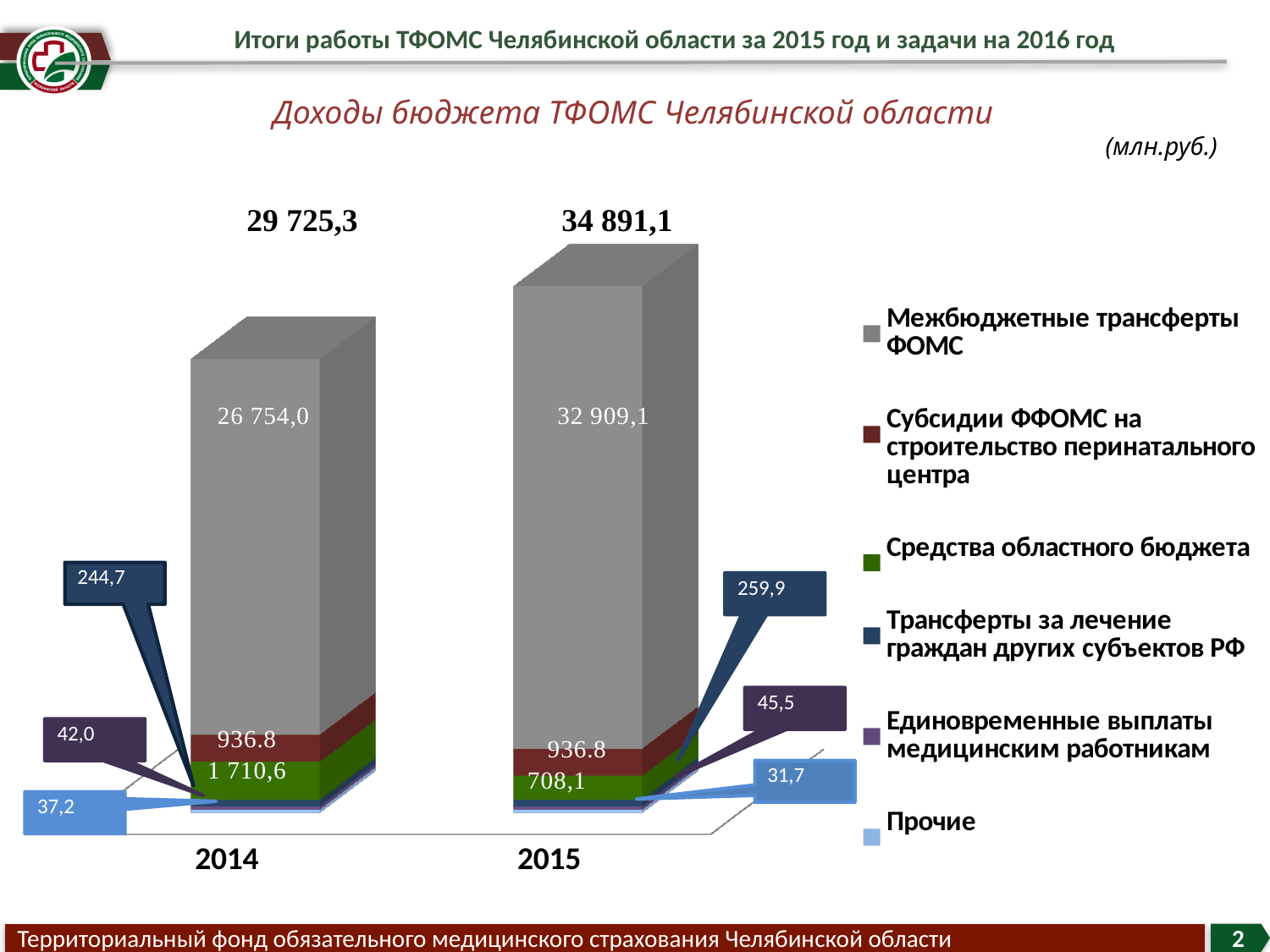
What is the value of Прочие for 2014? 37,2 What type of chart is shown on the slide? Stacked bar chart What is the difference between the total budget income in 2015 and in 2014? 5 165,8 Did the total budget income rise or fall from 2014 to 2015? Rise What is the value of Трансферты за лечение граждан других субъектов РФ for 2015? 259,9 How many series does the legend list? 6 What is the value of Средства областного бюджета for 2015? 708,1 Which year has the larger value for Средства областного бюджета, 2014 or 2015? 2014 By how much did Межбюджетные трансферты ФОМС increase from 2014 to 2015? 6 155,1 How many years (categories) are shown on the x axis? 2 What is the value of Межбюджетные трансферты ФОМС for 2014? 26 754,0 What is the total budget income shown above the bar for 2015? 34 891,1